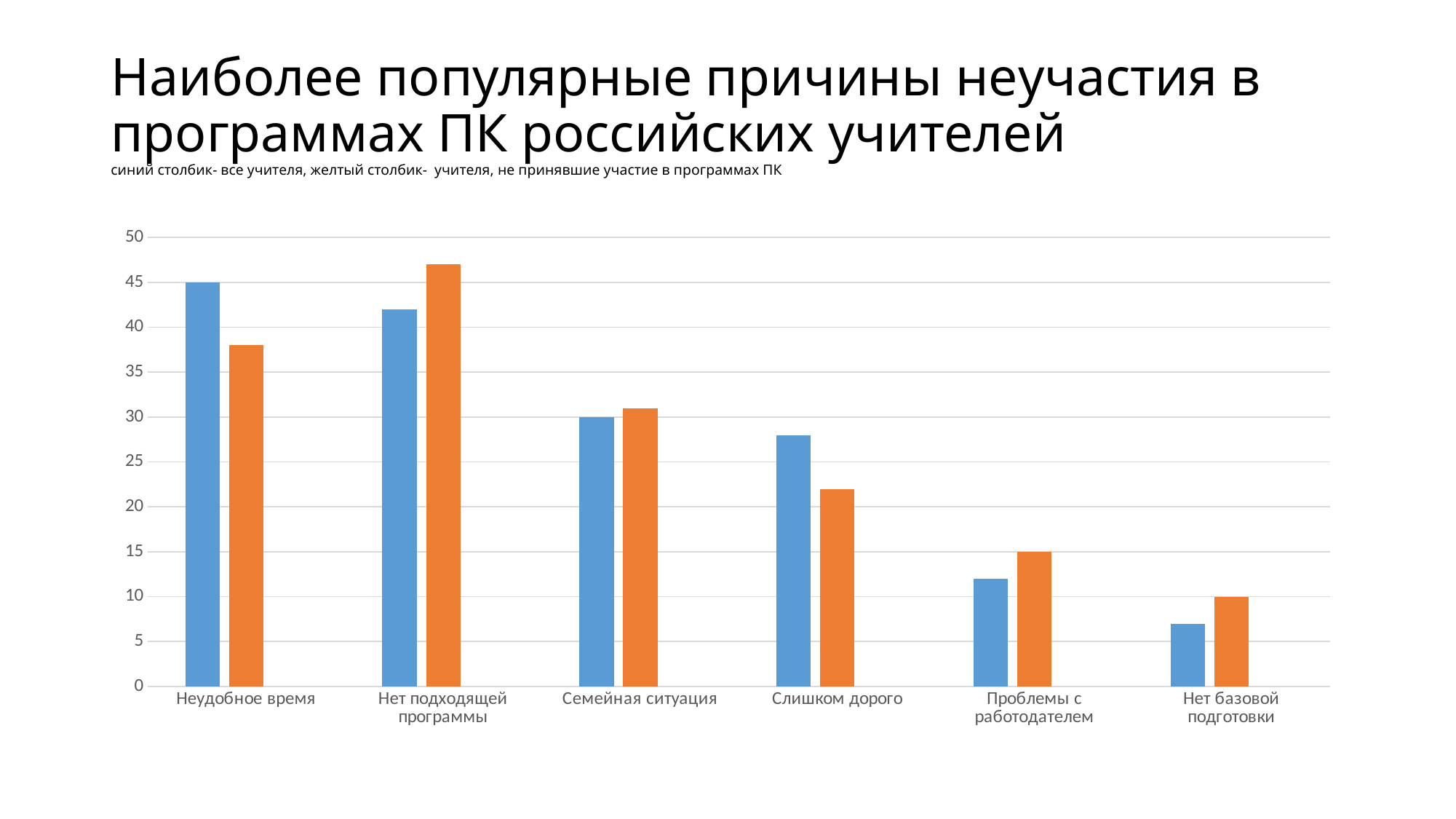
How many categories (reasons) are shown on the x axis? 6 What type of chart is shown on the slide? bar chart For "Слишком дорого", which bar is larger, the blue or the orange? blue What is the value of the orange bar for "Нет базовой подготовки"? 10 What is the value of the blue bar for "Неудобное время"? 45 Which category has the lowest blue bar? Нет базовой подготовки Which category has the highest orange bar? Нет подходящей программы What is the value of the orange bar for "Проблемы с работодателем"? 15 What is the value of the blue bar for "Семейная ситуация"? 30 Is the orange bar for "Нет подходящей программы" greater or less than 45? greater According to the subtitle, which group of teachers does the blue bar represent? все учителя Is the orange bar for "Слишком дорого" greater or less than 25? less